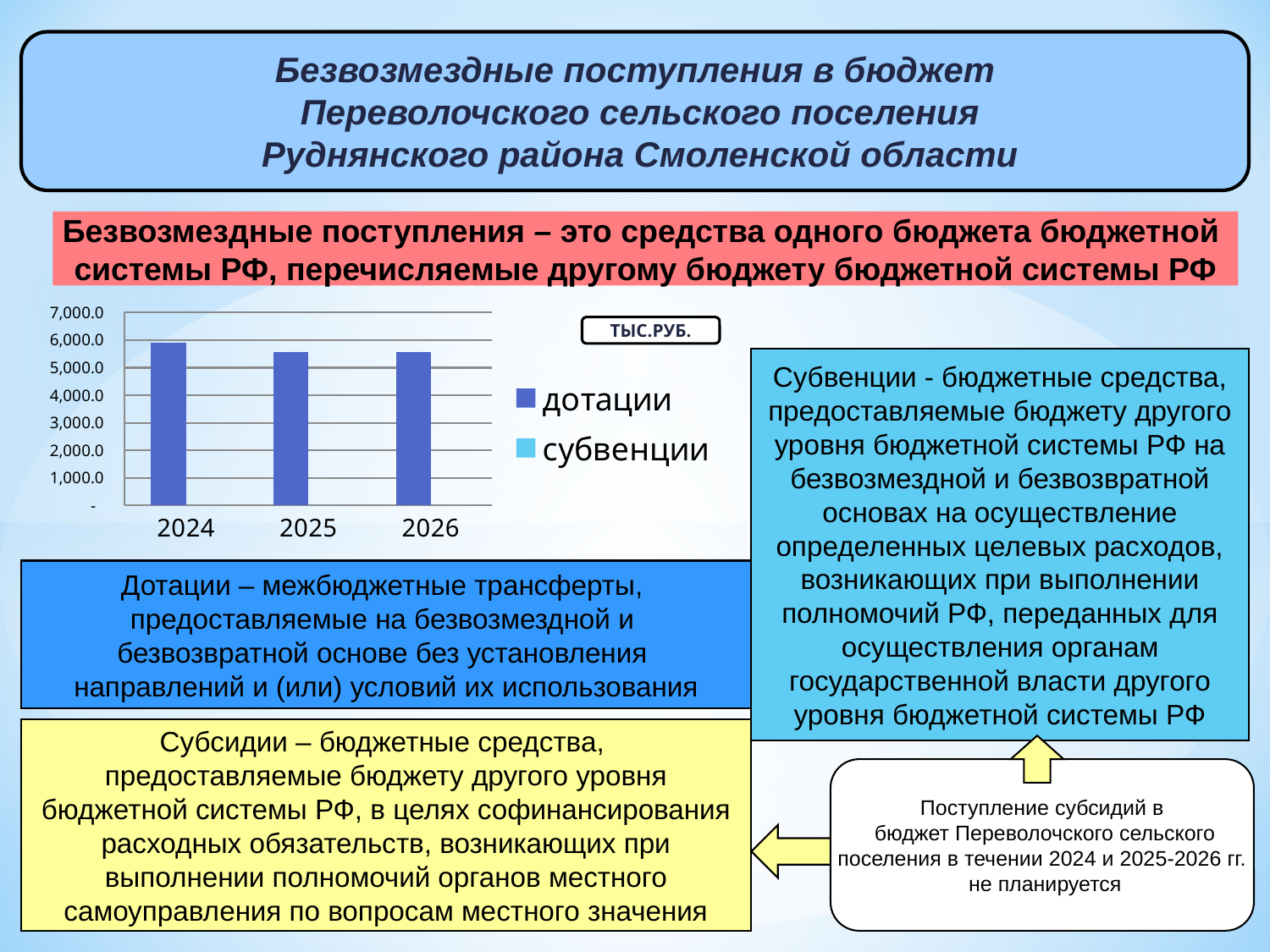
Is the дотации value for 2024 greater or less than 5,000.0? greater What are the two series named in the chart legend? дотации and субвенции Which year has the highest дотации bar in the chart? 2024 How many years are shown on the x axis of the chart? 3 Is the дотации value for 2025 greater or less than 4,000.0? greater What unit is indicated in the box next to the chart? ТЫС.РУБ. Is the дотации value for 2025 greater or less than 6,000.0? less What kind of chart is shown on the slide? bar chart Do the дотации values rise or fall from 2024 to 2025? fall Which is larger, the дотации value for 2024 or for 2025? 2024 How many series does the chart legend list? 2